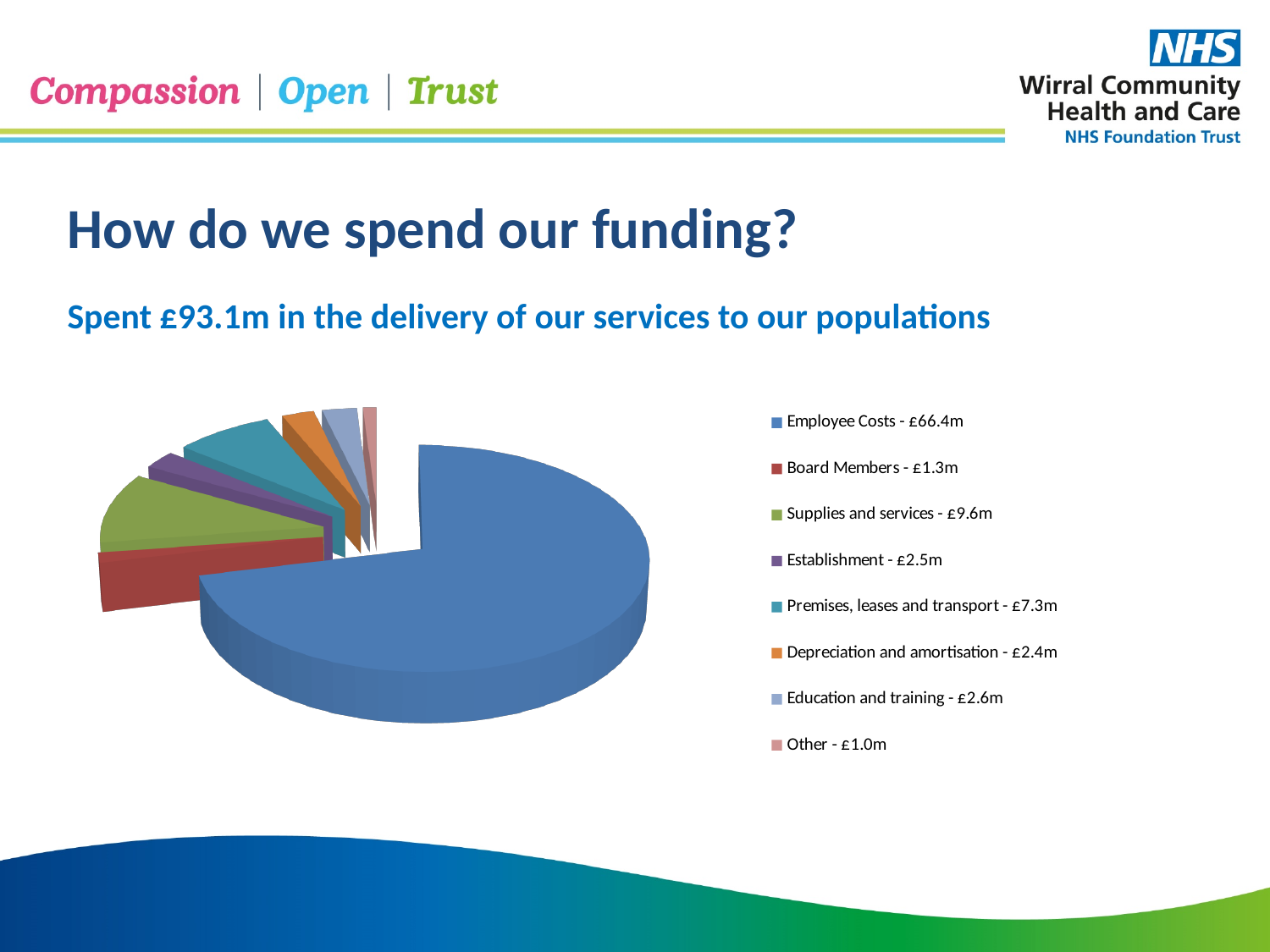
What kind of chart is shown on the slide? Pie chart What is the value for Education and training? £2.6m What colour is the Employee Costs slice in the pie chart? Blue What is the value for Premises, leases and transport? £7.3m Which is larger, Establishment or Depreciation and amortisation? Establishment Which category has the largest value in the pie chart? Employee Costs What is the total spend across all categories in the pie chart? £93.1m What is the difference between Supplies and services and Premises, leases and transport? £2.3m What is the value for Supplies and services? £9.6m What is the value for Employee Costs? £66.4m How many categories does the pie chart's legend list? 8 Which category has the smallest value in the pie chart? Other